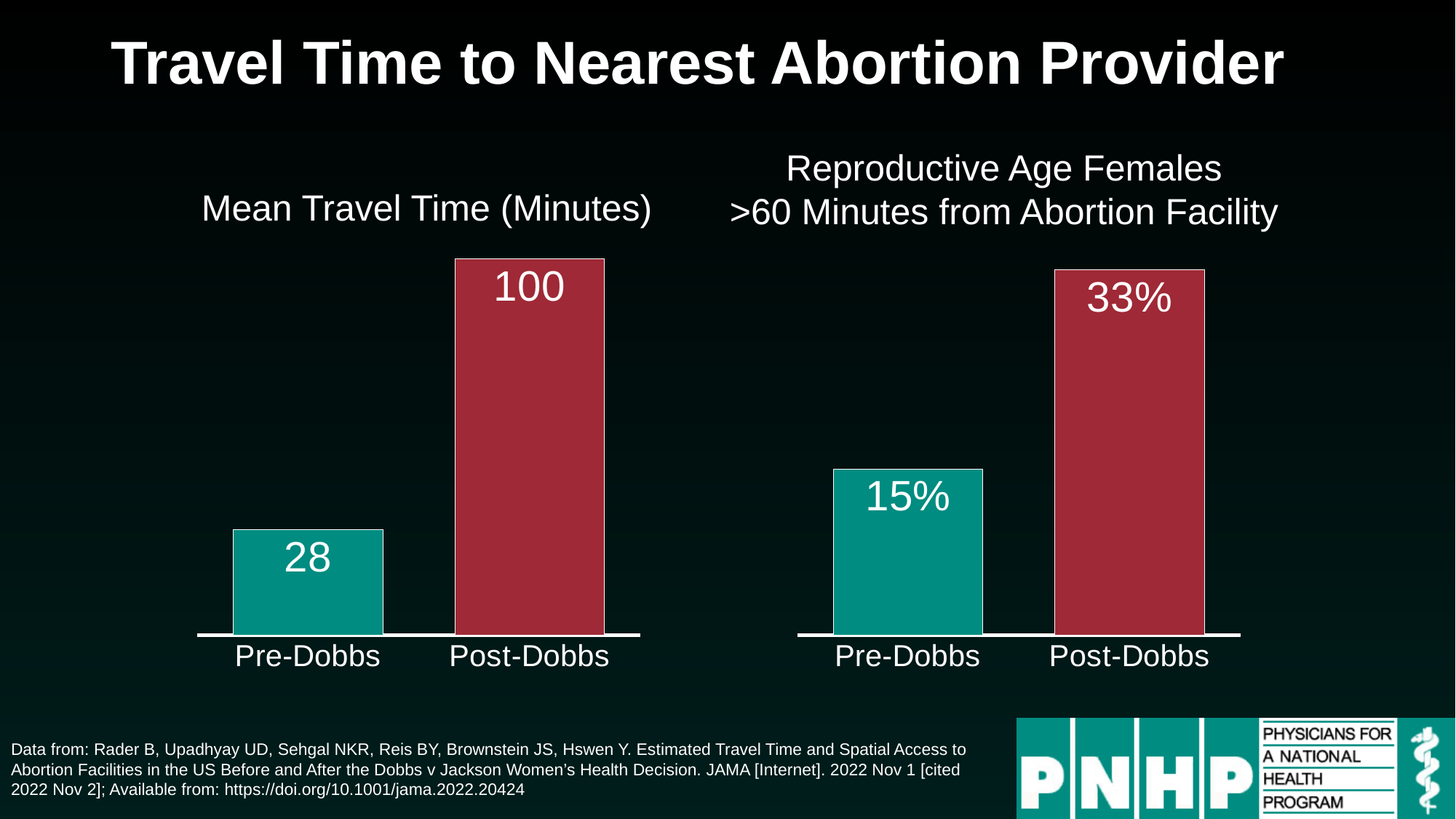
In the 'Reproductive Age Females >60 Minutes from Abortion Facility' chart, what is the difference between the Post-Dobbs and Pre-Dobbs values? 18% In the 'Reproductive Age Females >60 Minutes from Abortion Facility' chart, which category has the lowest value? Pre-Dobbs In the 'Mean Travel Time (Minutes)' chart, what is the difference between the Post-Dobbs and Pre-Dobbs values? 72 How many categories are shown in the 'Reproductive Age Females >60 Minutes from Abortion Facility' chart? 2 In the 'Mean Travel Time (Minutes)' chart, what is the value for Post-Dobbs? 100 In the 'Mean Travel Time (Minutes)' chart, what is the value for Pre-Dobbs? 28 What is the title of the chart on the left side of the slide? Mean Travel Time (Minutes) What kind of chart is the 'Mean Travel Time (Minutes)' chart? Bar chart In the 'Reproductive Age Females >60 Minutes from Abortion Facility' chart, what is the value for Post-Dobbs? 33% In the 'Mean Travel Time (Minutes)' chart, which is larger, Pre-Dobbs or Post-Dobbs? Post-Dobbs In the 'Mean Travel Time (Minutes)' chart, which category has the highest value? Post-Dobbs In the 'Reproductive Age Females >60 Minutes from Abortion Facility' chart, what is the value for Pre-Dobbs? 15%